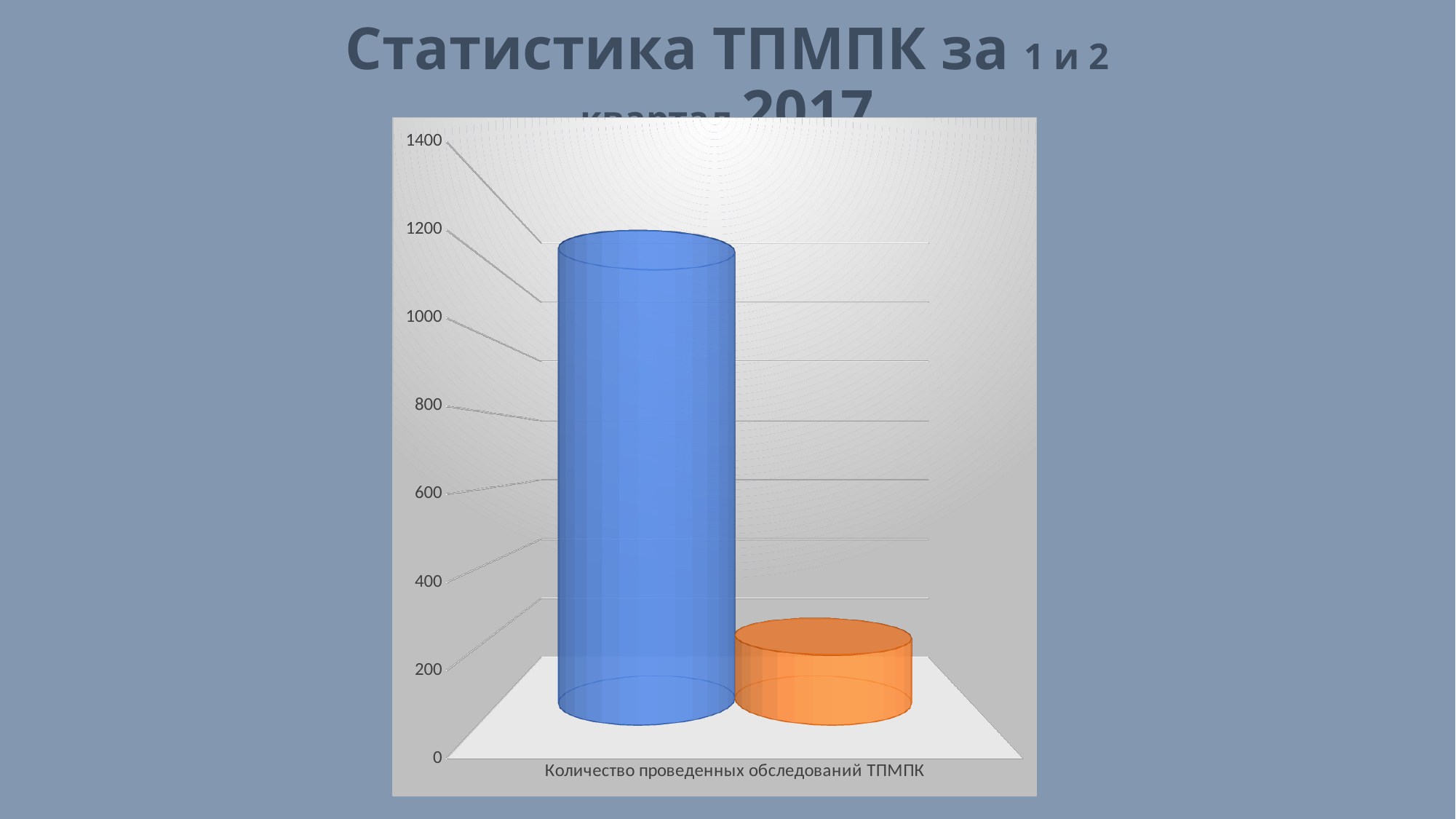
How many categories are labelled on the x axis of the chart? 1 Is the value of the blue bar greater or less than 1000? greater What is the highest value shown on the vertical axis of the chart? 1400 Is the value of the orange bar greater or less than 400? less How many bars are plotted in the chart? 2 Which bar is taller, the blue one or the orange one? the blue one Which bar has the lowest value in the chart? the orange bar Is the value of the blue bar greater or less than 800? greater What is the category label shown on the x axis of the chart? Количество проведенных обследований ТПМПК What kind of chart is shown on the slide? bar chart